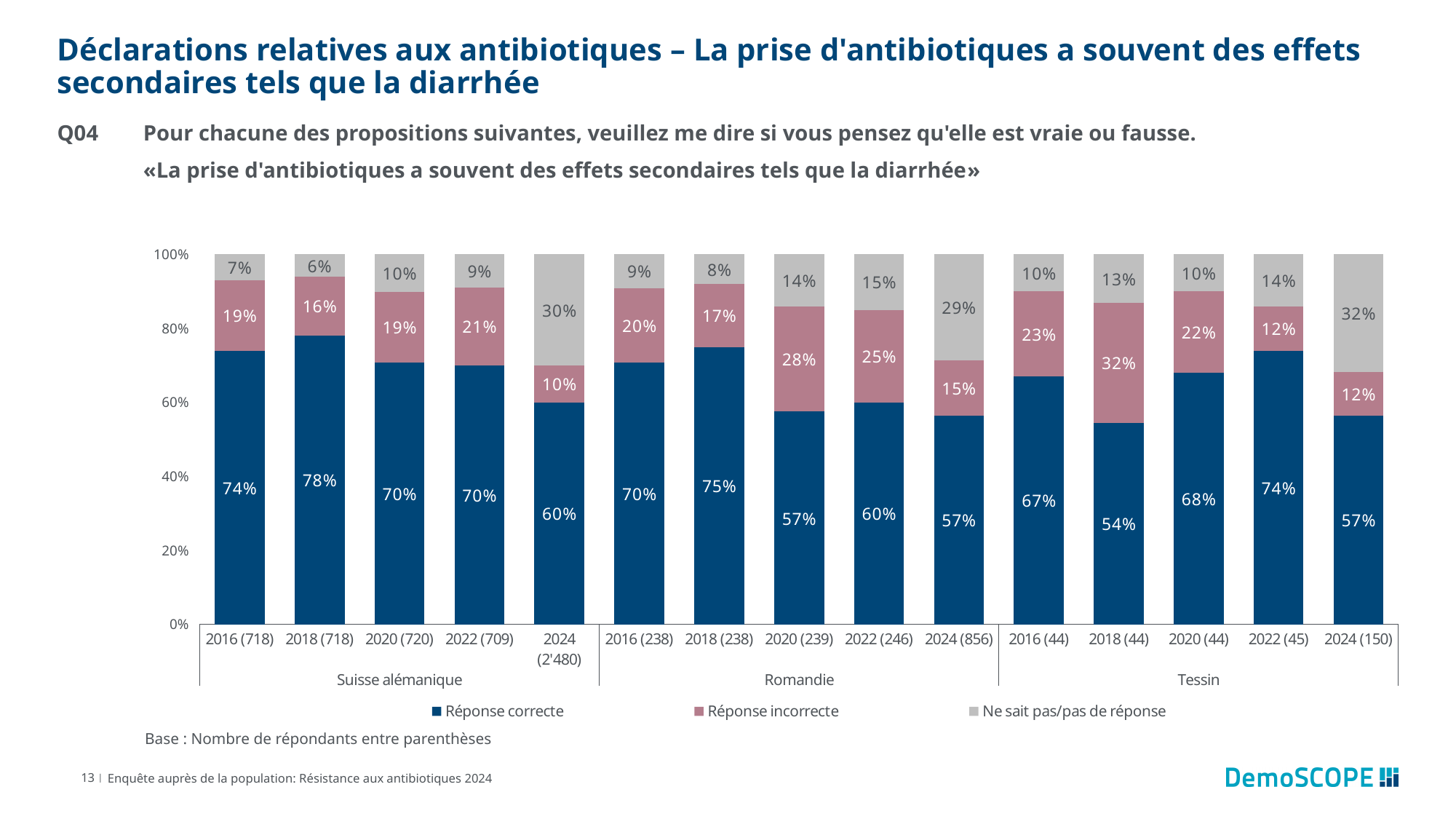
What is the difference between the correct-answer share in Suisse alémanique in 2018 and in 2024? 18 percentage points How many series does the legend list? 3 What percentage of respondents in Suisse alémanique gave the correct answer (Réponse correcte) in 2024? 60% What is the 'Ne sait pas/pas de réponse' share for Tessin in 2024? 32% What type of chart is shown on the slide? Stacked bar chart Which is larger: the 'Réponse incorrecte' share for Tessin in 2018 or for Romandie in 2018? Tessin 2018 What is the number of respondents (base) for Suisse alémanique in 2024? 2'480 In which year did Suisse alémanique have the highest share of correct answers? 2018 Which Tessin year has the lowest share of correct answers? 2018 How many bars are shown for the Romandie region? 5 What percentage of respondents in Romandie gave an incorrect answer (Réponse incorrecte) in 2020? 28% Did the share of correct answers in Romandie rise or fall from 2018 to 2020? Fall